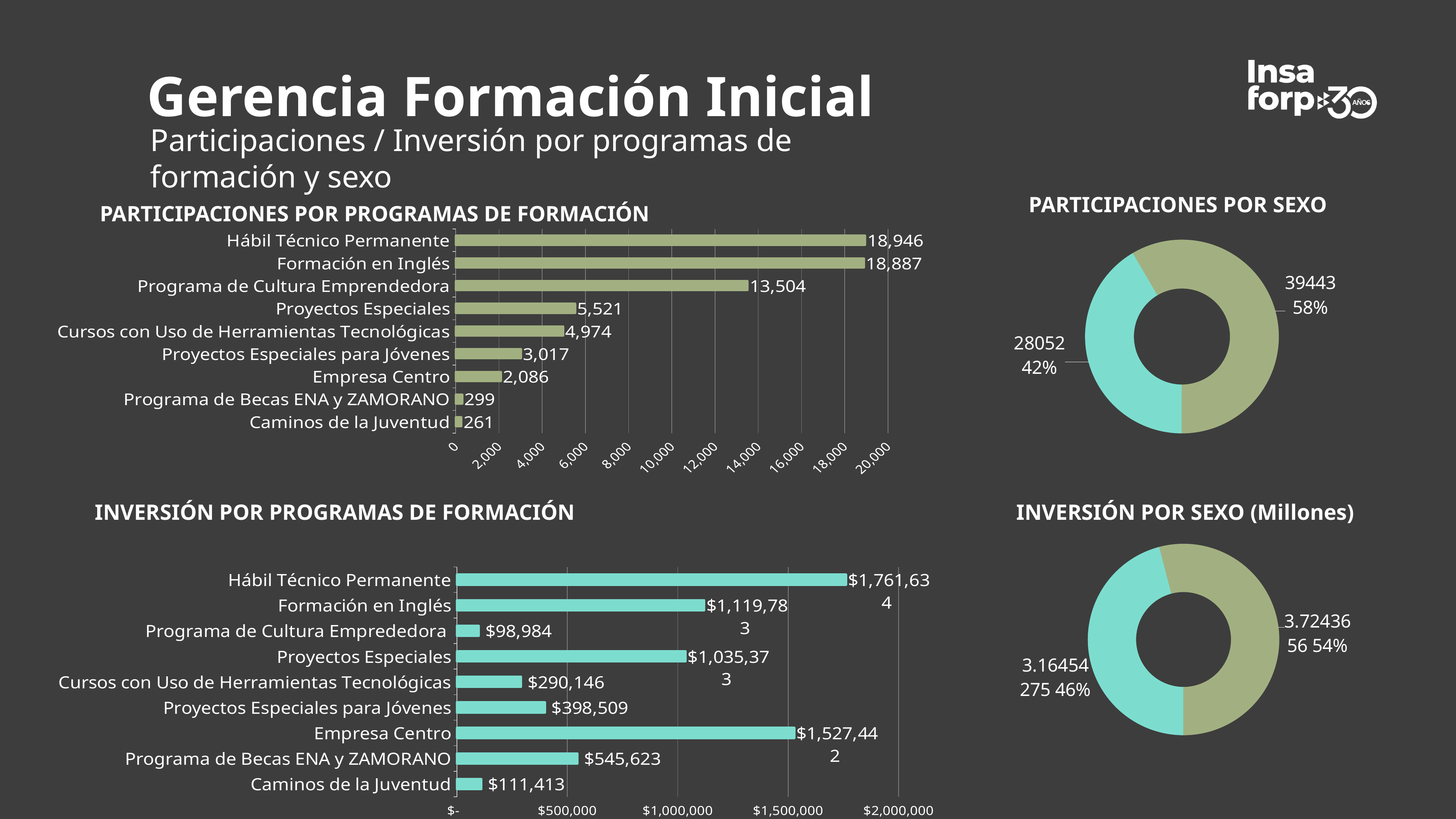
In the chart 'PARTICIPACIONES POR PROGRAMAS DE FORMACIÓN', what is the difference between Programa de Cultura Emprendedora and Proyectos Especiales? 7,983 In the chart 'PARTICIPACIONES POR PROGRAMAS DE FORMACIÓN', what is the value for Hábil Técnico Permanente? 18,946 In the chart 'INVERSIÓN POR PROGRAMAS DE FORMACIÓN', what is the difference between Programa de Becas ENA y ZAMORANO and Caminos de la Juventud? $434,210 In the chart 'PARTICIPACIONES POR PROGRAMAS DE FORMACIÓN', how many programs are shown? 9 In the chart 'INVERSIÓN POR PROGRAMAS DE FORMACIÓN', which program has the lowest investment? Programa de Cultura Emprededora What kind of chart is 'INVERSIÓN POR PROGRAMAS DE FORMACIÓN'? Bar chart In the chart 'INVERSIÓN POR PROGRAMAS DE FORMACIÓN', what is the value for Empresa Centro? $1,527,442 In the chart 'INVERSIÓN POR SEXO (Millones)', what percentage is shown for the smaller slice? 46% In the chart 'PARTICIPACIONES POR PROGRAMAS DE FORMACIÓN', which is larger: Cursos con Uso de Herramientas Tecnológicas or Proyectos Especiales para Jóvenes? Cursos con Uso de Herramientas Tecnológicas In the chart 'INVERSIÓN POR PROGRAMAS DE FORMACIÓN', which program has the highest investment? Hábil Técnico Permanente In the chart 'PARTICIPACIONES POR SEXO', what share does the slice with 39443 participations represent? 58% In the chart 'PARTICIPACIONES POR PROGRAMAS DE FORMACIÓN', which program has the lowest number of participations? Caminos de la Juventud